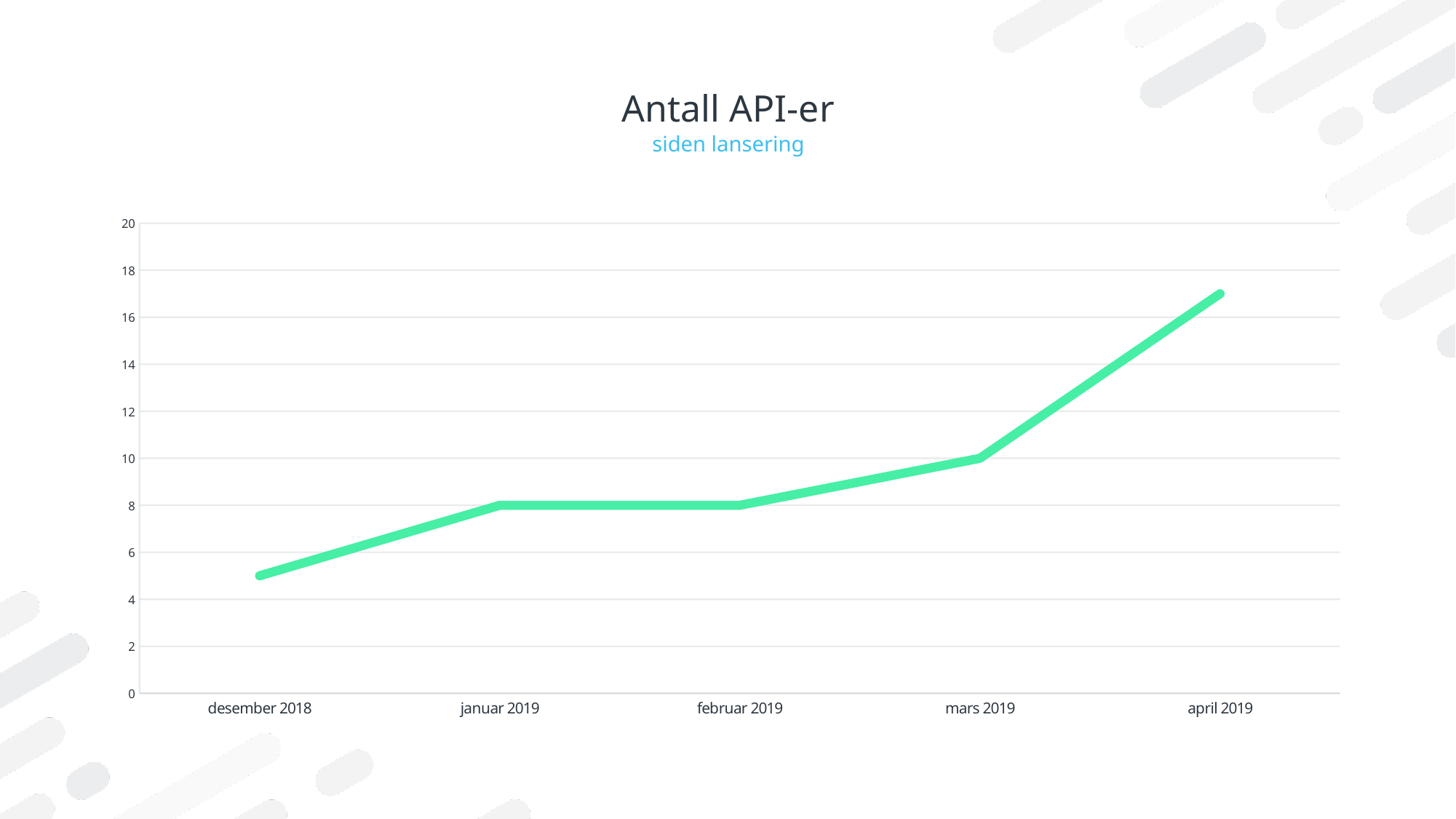
What is the value for februar 2019? 8 Do the values rise or fall from desember 2018 to april 2019? rise Which month has the highest value? april 2019 How many points are plotted on the line? 5 What is the value for januar 2019? 8 What is the title of the chart? Antall API-er Which month has the lowest value? desember 2018 Is the value for april 2019 greater or less than 16? greater What is the value for mars 2019? 10 What kind of chart is shown on the slide? line chart What is the difference between the values for mars 2019 and januar 2019? 2 Is the value for desember 2018 greater or less than 6? less